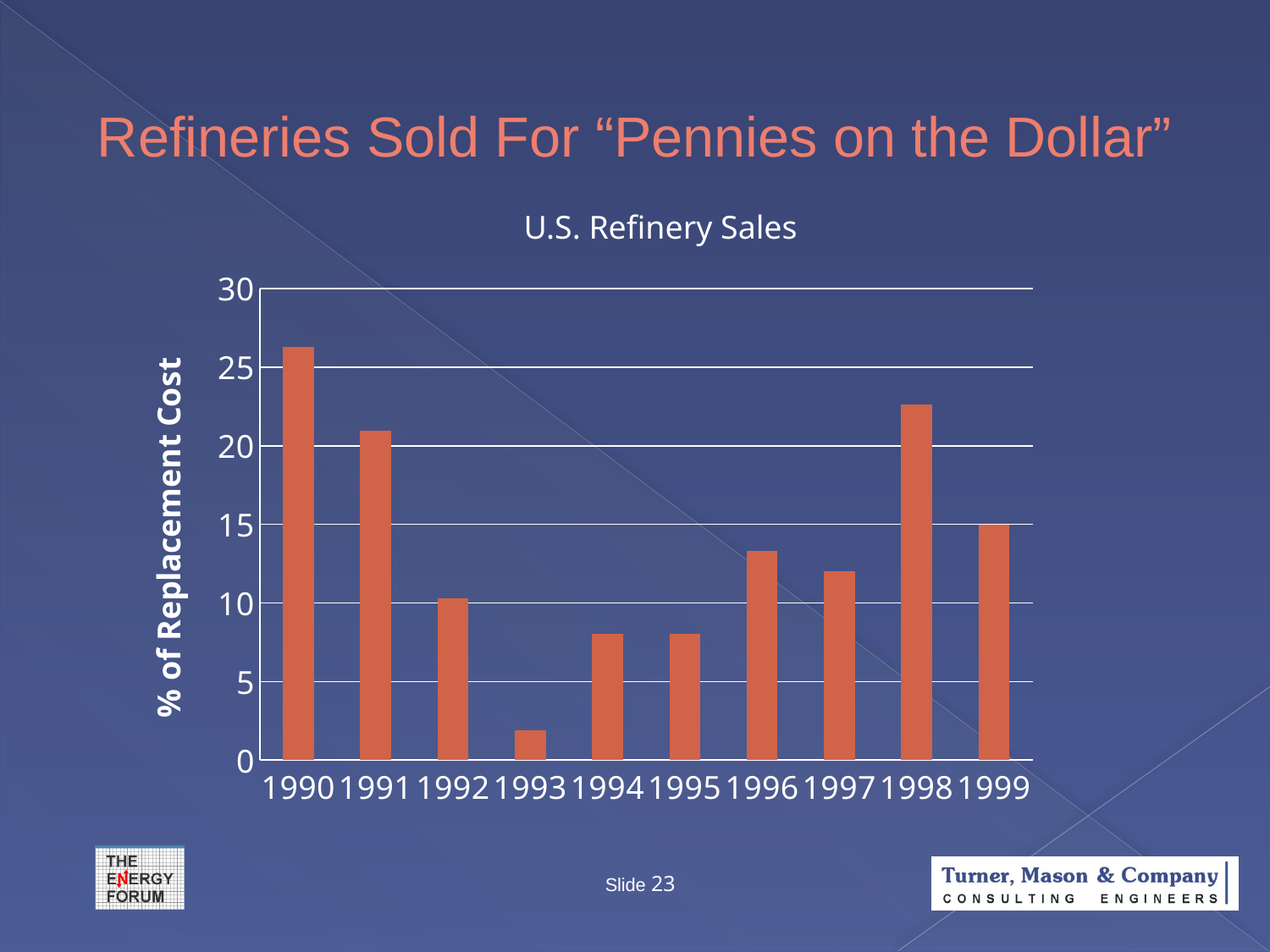
How many years are shown on the x axis of the chart? 10 Which year has the larger value, 1991 or 1992? 1991 Which year has the highest % of replacement cost? 1990 Is the value for 1990 greater or less than 25? greater Which year has the lowest % of replacement cost? 1993 Is the value for 1993 greater or less than 5? less What is the title of the chart? U.S. Refinery Sales What kind of chart is shown on the slide? bar chart Which year has the larger value, 1998 or 1999? 1998 Is the value for 1998 greater or less than 20? greater What is the label on the vertical axis of the chart? % of Replacement Cost